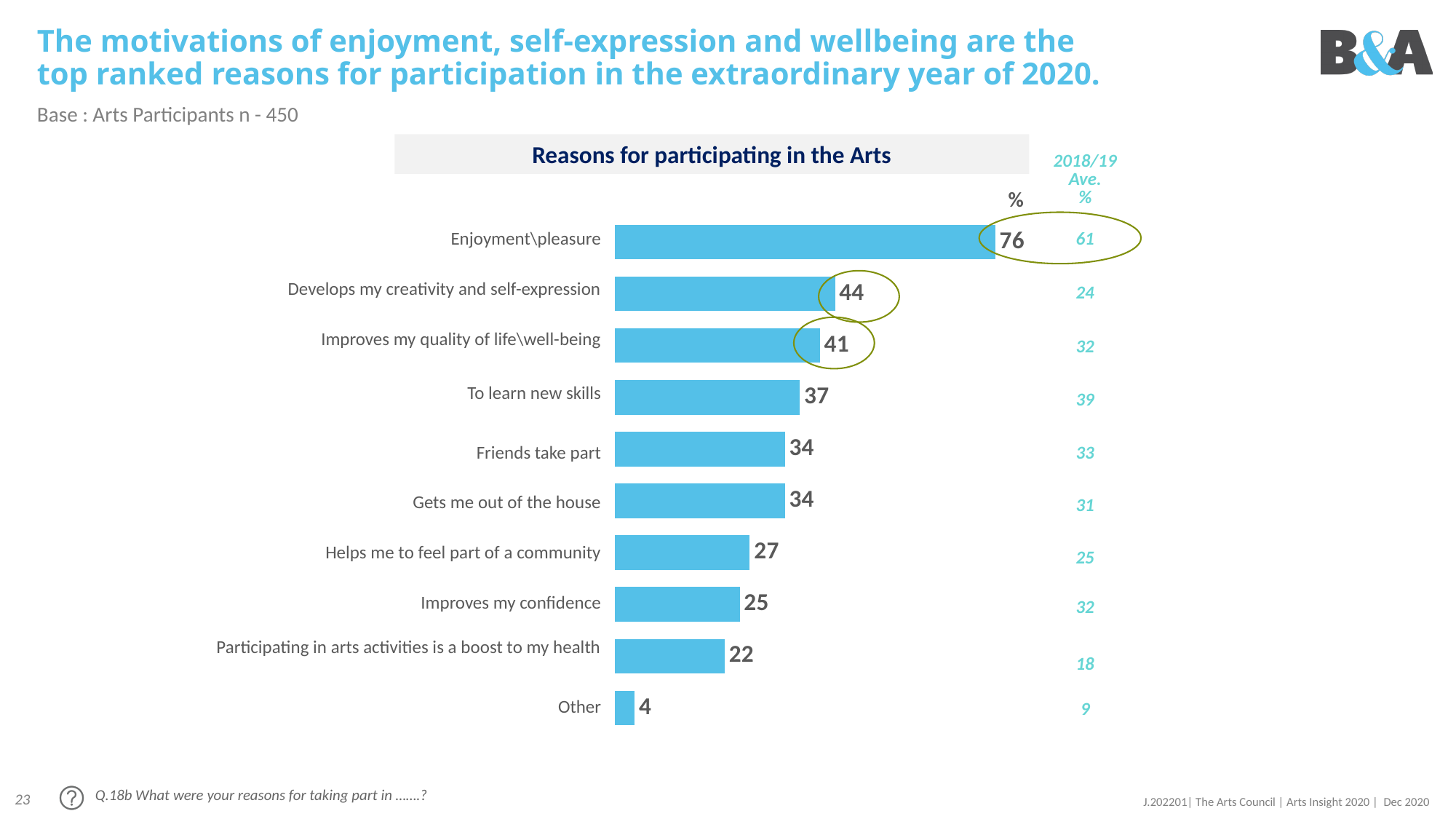
What is the value for Enjoyment\pleasure in the Reasons for participating in the Arts chart? 76 What is the difference between the values for Enjoyment\pleasure and Develops my creativity and self-expression? 32 What is the 2018/19 Ave. % shown next to Enjoyment\pleasure? 61 What is the value for Participating in arts activities is a boost to my health? 22 How many categories are shown in the chart? 10 Which is larger, the value for Improves my quality of life\well-being or the value for Helps me to feel part of a community? Improves my quality of life\well-being Which category has the lowest value in the chart? Other What kind of chart is shown on the slide? Bar chart What is the title of the chart? Reasons for participating in the Arts Which category has the highest value in the chart? Enjoyment\pleasure What is the value for To learn new skills? 37 What is the difference between the values for Improves my confidence and Other? 21